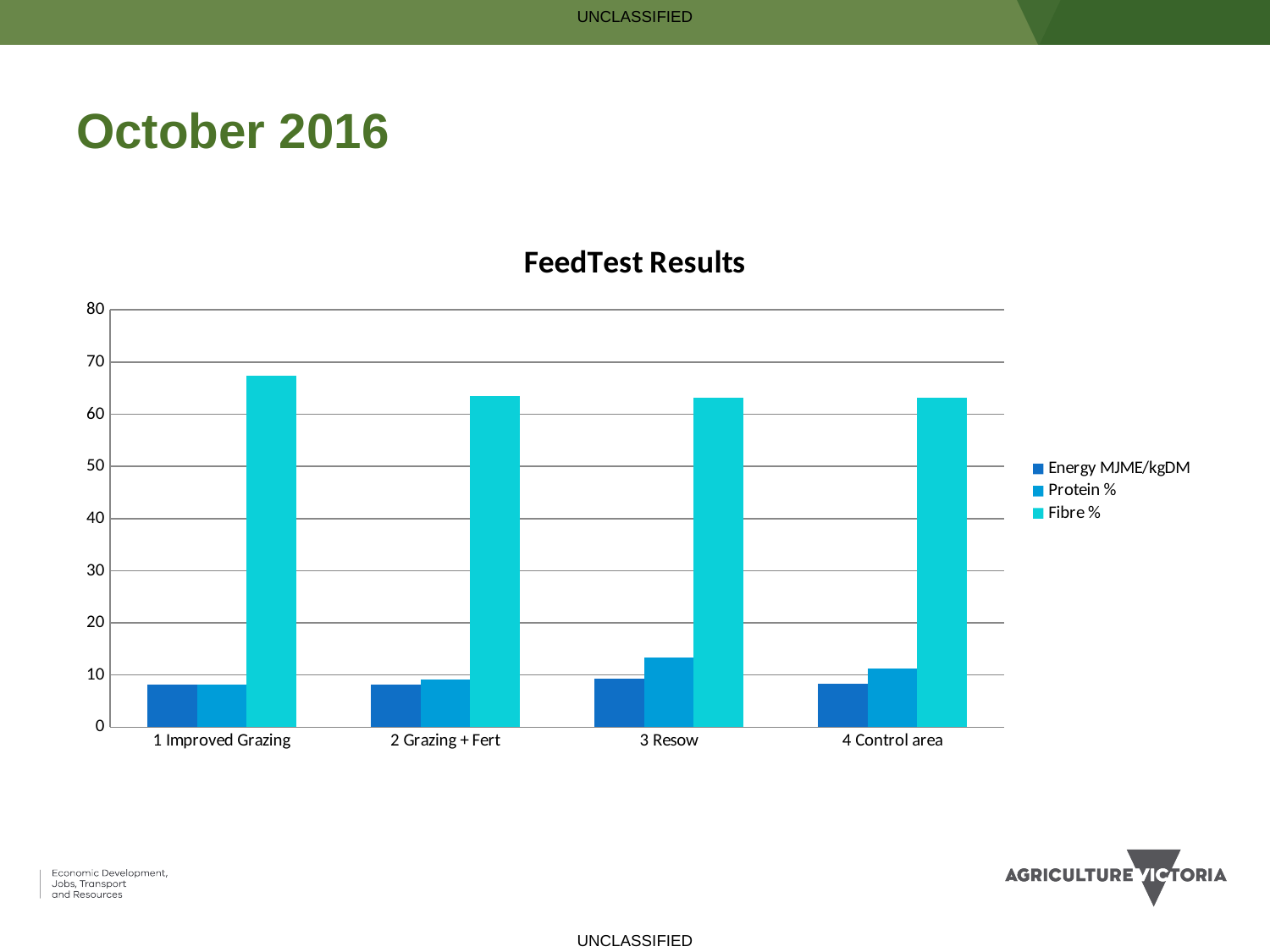
Which category has the highest Protein % value in the FeedTest Results chart? 3 Resow Is the Protein % value for 3 Resow greater or less than 10? greater What type of chart is shown under the title "FeedTest Results"? bar chart Is the Fibre % value for 1 Improved Grazing greater or less than 60? greater Which is larger in the FeedTest Results chart: the Protein % value for 3 Resow or for 4 Control area? 3 Resow How many series does the legend of the FeedTest Results chart list? 3 How many categories are shown on the x axis of the FeedTest Results chart? 4 Is the Energy MJME/kgDM value for 1 Improved Grazing greater or less than 10? less Which category has the highest Fibre % value in the FeedTest Results chart? 1 Improved Grazing What is the title of the chart on the slide? FeedTest Results Which is larger in the FeedTest Results chart: the Fibre % value for 1 Improved Grazing or for 3 Resow? 1 Improved Grazing